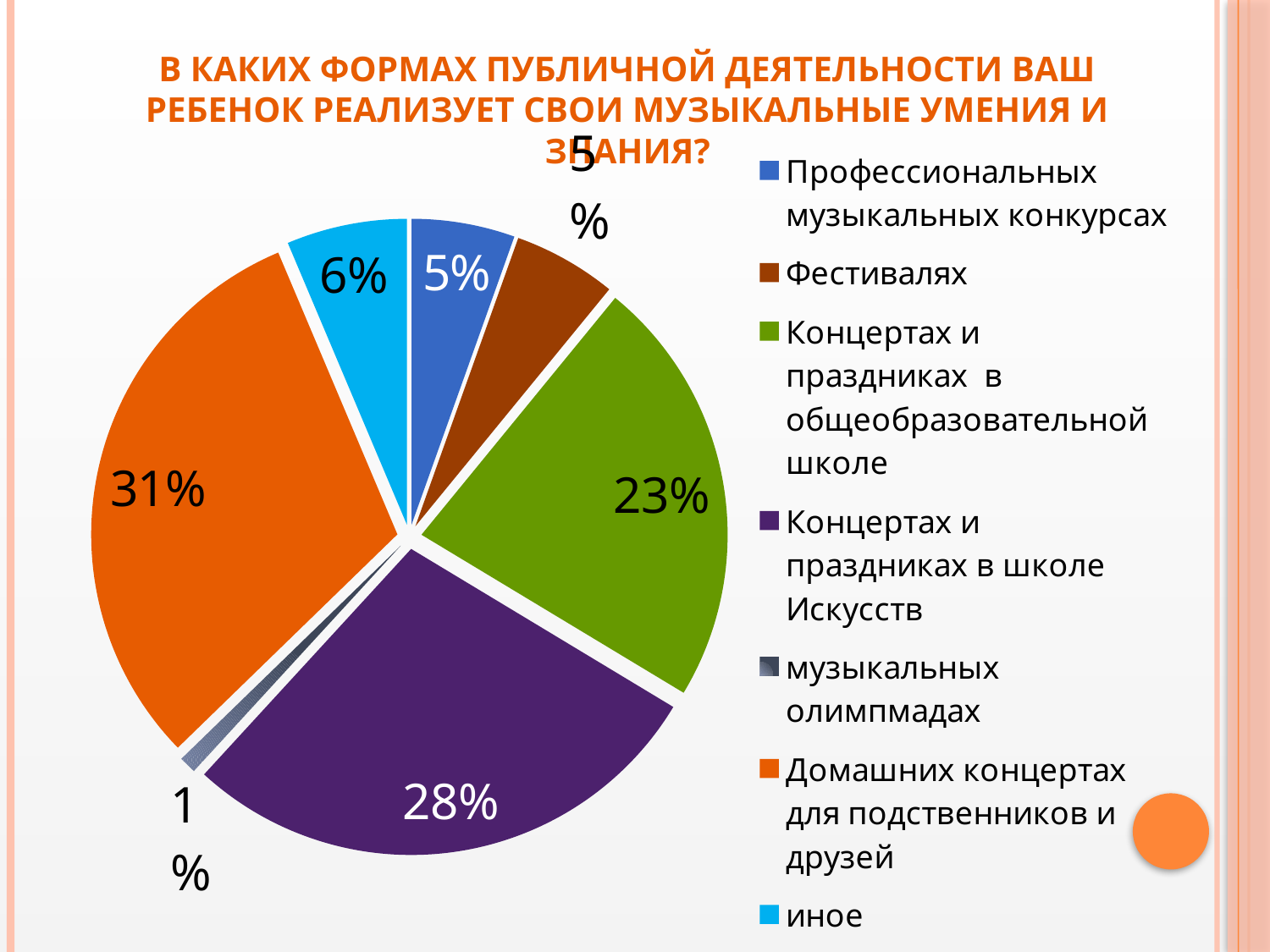
What percentage of the pie chart is for "Домашних концертах для подственников и друзей"? 31% What type of chart is shown on the slide? Pie chart What colour is the slice for "Фестивалях"? Brown Which is larger: the share for "Концертах и праздниках в общеобразовательной школе" or the share for "иное"? Концертах и праздниках в общеобразовательной школе What percentage is shown for "музыкальных олимпмадах"? 1% What percentage is shown for "иное"? 6% What percentage is shown for "Концертах и праздниках в общеобразовательной школе"? 23% Which category has the smallest share of the pie chart? музыкальных олимпмадах What percentage is shown for "Концертах и праздниках в школе Искусств"? 28% Which category has the largest share of the pie chart? Домашних концертах для подственников и друзей How many categories does the legend of the pie chart list? 7 What is the difference in percentage points between "Домашних концертах для подственников и друзей" and "Концертах и праздниках в школе Искусств"? 3